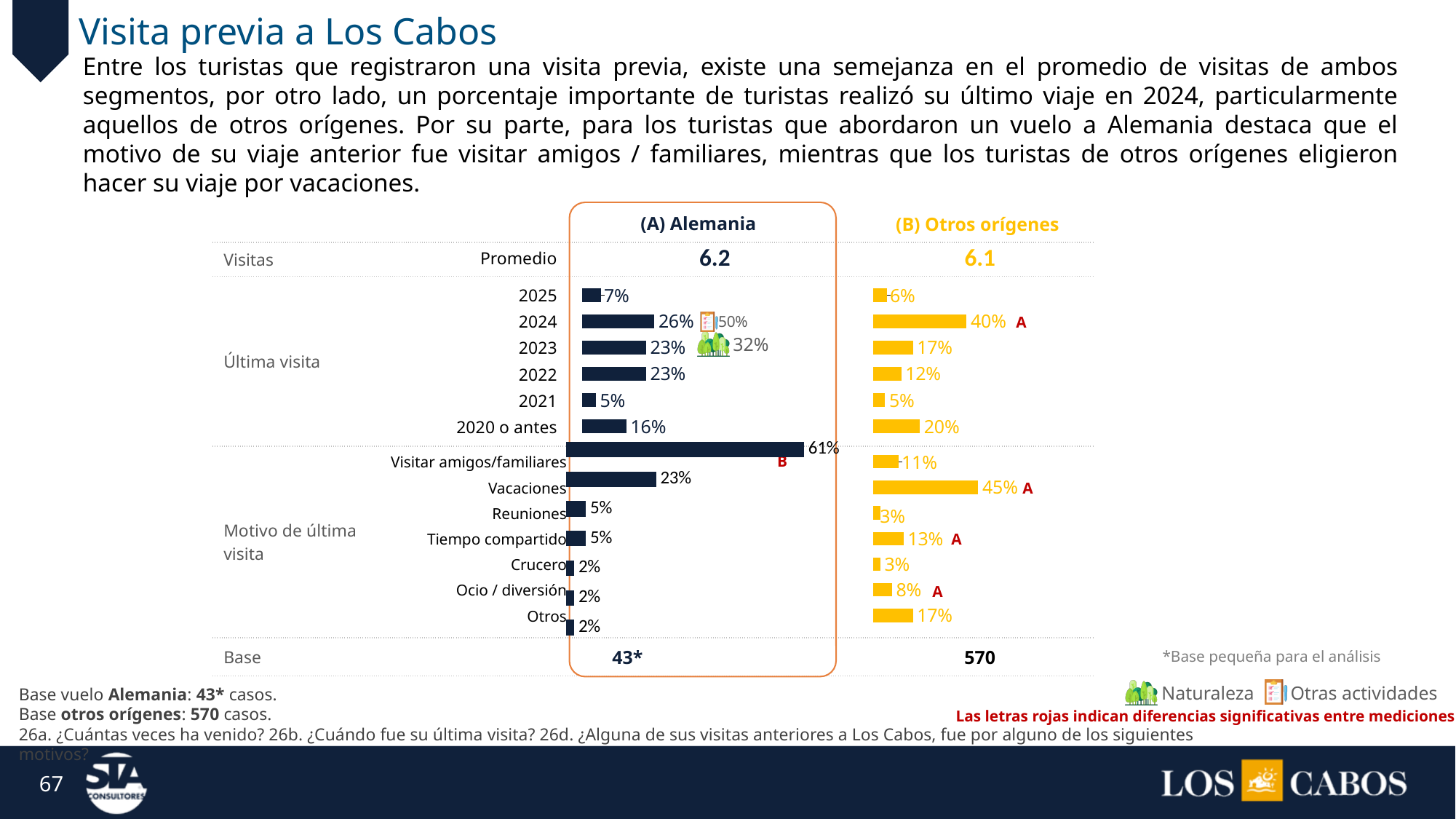
In the 'Última visita' bars for (B) Otros orígenes, which year has the lowest value? 2021 In the 'Motivo de última visita' bars for (A) Alemania, which motive has the highest value? Visitar amigos/familiares What is the 'Base' shown for (B) Otros orígenes? 570 In the 'Motivo de última visita' bars for (B) Otros orígenes, which motive has the highest value? Vacaciones How many motives are listed in the 'Motivo de última visita' section? 7 In the 'Última visita' bars for (B) Otros orígenes, what is the value for 2020 o antes? 20% What is the 'Promedio' number of visits shown for (A) Alemania? 6.2 What is the difference between the 2024 values for (B) Otros orígenes and (A) Alemania in the 'Última visita' bars? 14 percentage points For 'Vacaciones' in the 'Motivo de última visita' bars, which segment has the larger value, (A) Alemania or (B) Otros orígenes? (B) Otros orígenes In the 'Última visita' bars for (A) Alemania, what is the value for 2024? 26% What is the difference between the 'Visitar amigos/familiares' values for (A) Alemania and (B) Otros orígenes? 50 percentage points What type of chart is used to show the 'Última visita' and 'Motivo de última visita' values? Bar chart